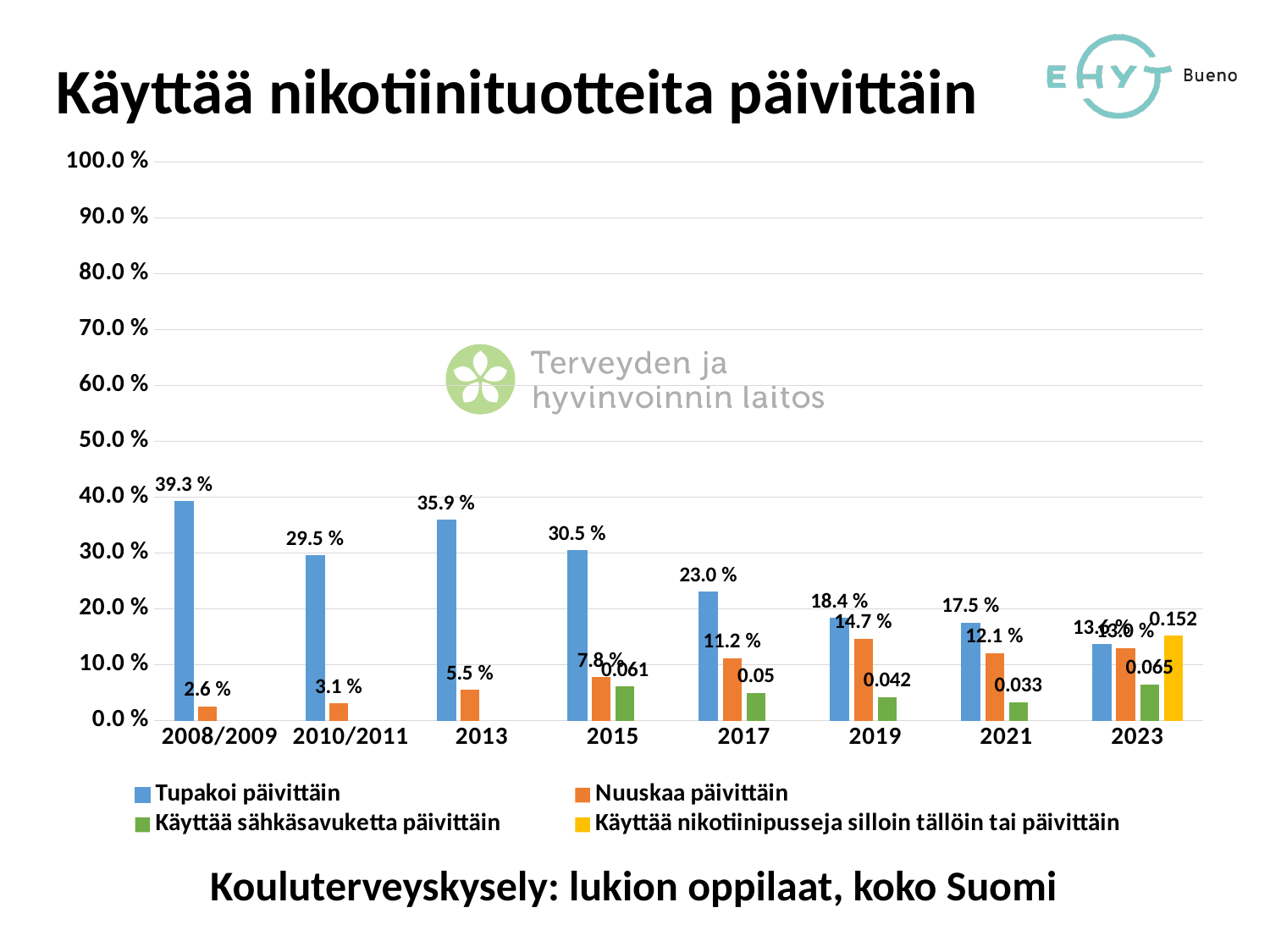
Is the value for Käyttää sähkäsavuketta päivittäin in 2015 greater or less than 10.0 %? less What is the difference between Tupakoi päivittäin in 2008/2009 and in 2010/2011? 9.8 % What is the value for Käyttää sähkäsavuketta päivittäin in 2021? 0.033 What is the value for Tupakoi päivittäin in 2008/2009? 39.3 % What is the value for Käyttää nikotiinipusseja silloin tällöin tai päivittäin in 2023? 0.152 In which year is Tupakoi päivittäin highest? 2008/2009 In which year is Nuuskaa päivittäin lowest? 2008/2009 Does Tupakoi päivittäin rise or fall from 2013 to 2021? fall How many series does the legend list? 4 How many year categories are shown on the x axis? 8 In 2019, which is larger: Tupakoi päivittäin or Nuuskaa päivittäin? Tupakoi päivittäin What is the value for Nuuskaa päivittäin in 2019? 14.7 %